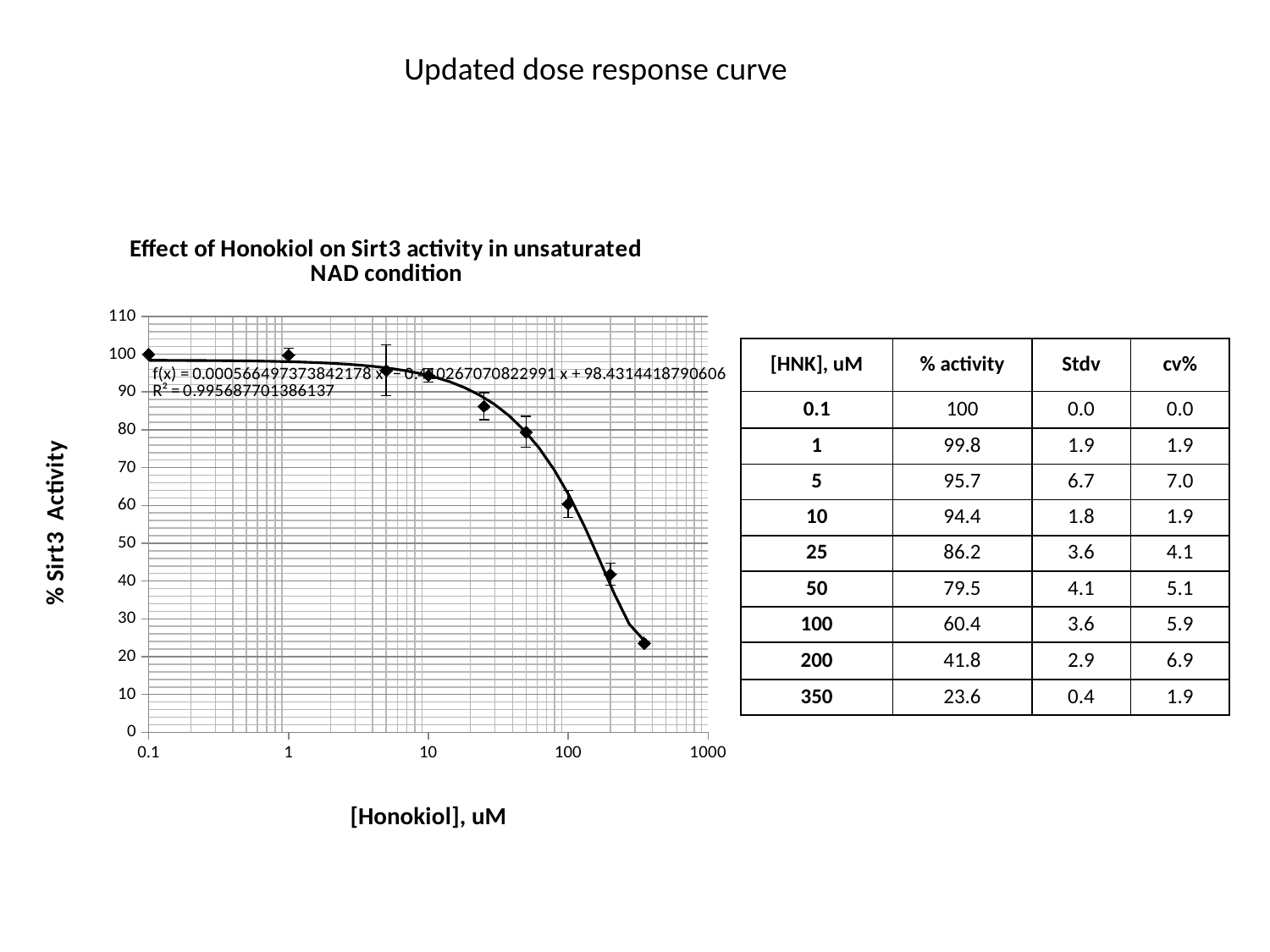
Which has higher % Sirt3 activity, 50 uM or 200 uM Honokiol? 50 uM What is the % Sirt3 activity at 100 uM Honokiol? 60.4 How many data points are plotted on the chart? 9 At which Honokiol concentration is the % Sirt3 activity highest? 0.1 uM What is the % Sirt3 activity at 350 uM Honokiol? 23.6 What kind of chart is shown on the slide? scatter chart What is the difference in % Sirt3 activity between 0.1 uM and 350 uM Honokiol? 76.4 At which Honokiol concentration is the % Sirt3 activity lowest? 350 uM Is the % Sirt3 activity at 200 uM Honokiol greater or less than 50? less What is the % Sirt3 activity at 25 uM Honokiol? 86.2 What is the title of the chart? Effect of Honokiol on Sirt3 activity in unsaturated NAD condition Does % Sirt3 activity rise or fall as Honokiol concentration increases along the x axis? fall